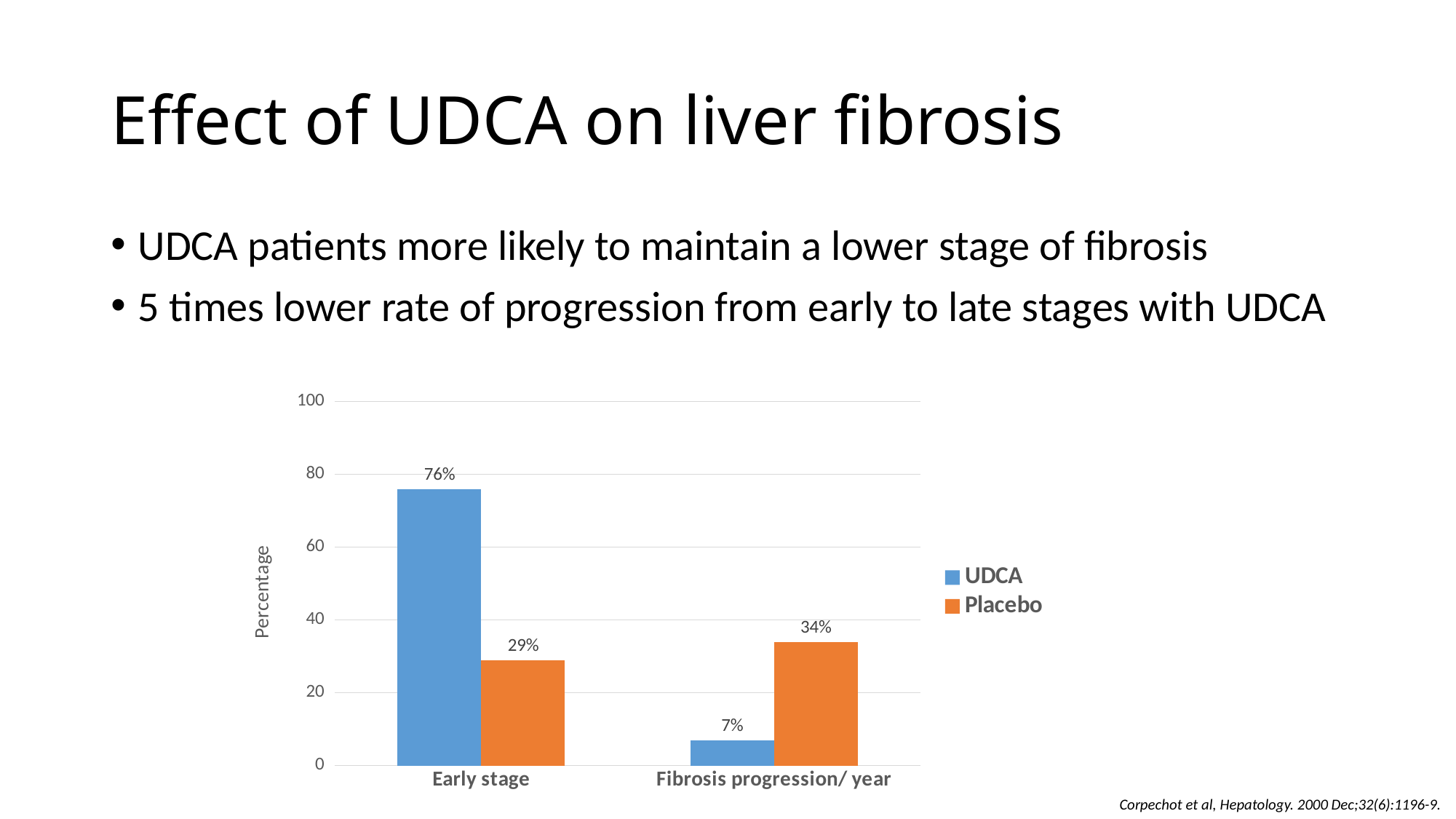
Which is larger for Fibrosis progression/ year, UDCA or Placebo? Placebo What is the UDCA value for Early stage? 76% How many series does the legend list? 2 What is the difference between the UDCA and Placebo values for Early stage? 47% Which series has the lowest value for Fibrosis progression/ year? UDCA What is the Placebo value for Fibrosis progression/ year? 34% Which series has the highest value for Early stage? UDCA What is the UDCA value for Fibrosis progression/ year? 7% What is the Placebo value for Early stage? 29% What is the difference between the Placebo and UDCA values for Fibrosis progression/ year? 27% How many categories are shown on the x axis? 2 What kind of chart is shown on the slide? Bar chart